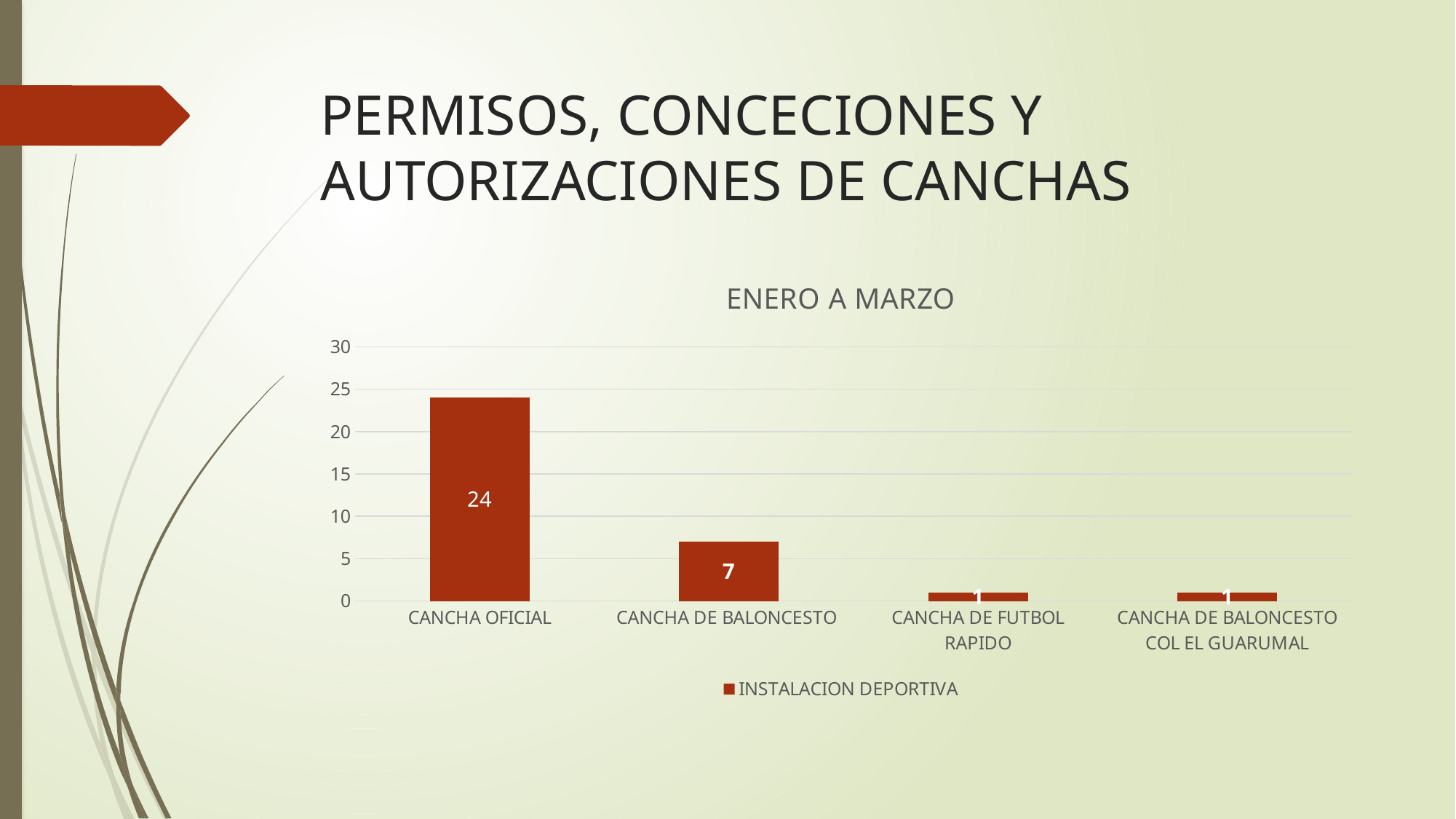
What is the value for CANCHA DE FUTBOL RAPIDO? 1 Which is larger, the value for CANCHA DE BALONCESTO or the value for CANCHA DE FUTBOL RAPIDO? CANCHA DE BALONCESTO Which category has the highest value? CANCHA OFICIAL How many series does the legend list? 1 Is the value for CANCHA OFICIAL greater or less than 20? greater What is the value for CANCHA OFICIAL? 24 What is the value for CANCHA DE BALONCESTO? 7 What kind of chart is shown on the slide? bar chart What is the value for CANCHA DE BALONCESTO COL EL GUARUMAL? 1 How many categories are shown on the x axis? 4 What is the difference between the values for CANCHA OFICIAL and CANCHA DE BALONCESTO? 17 What is the title of the chart? ENERO A MARZO